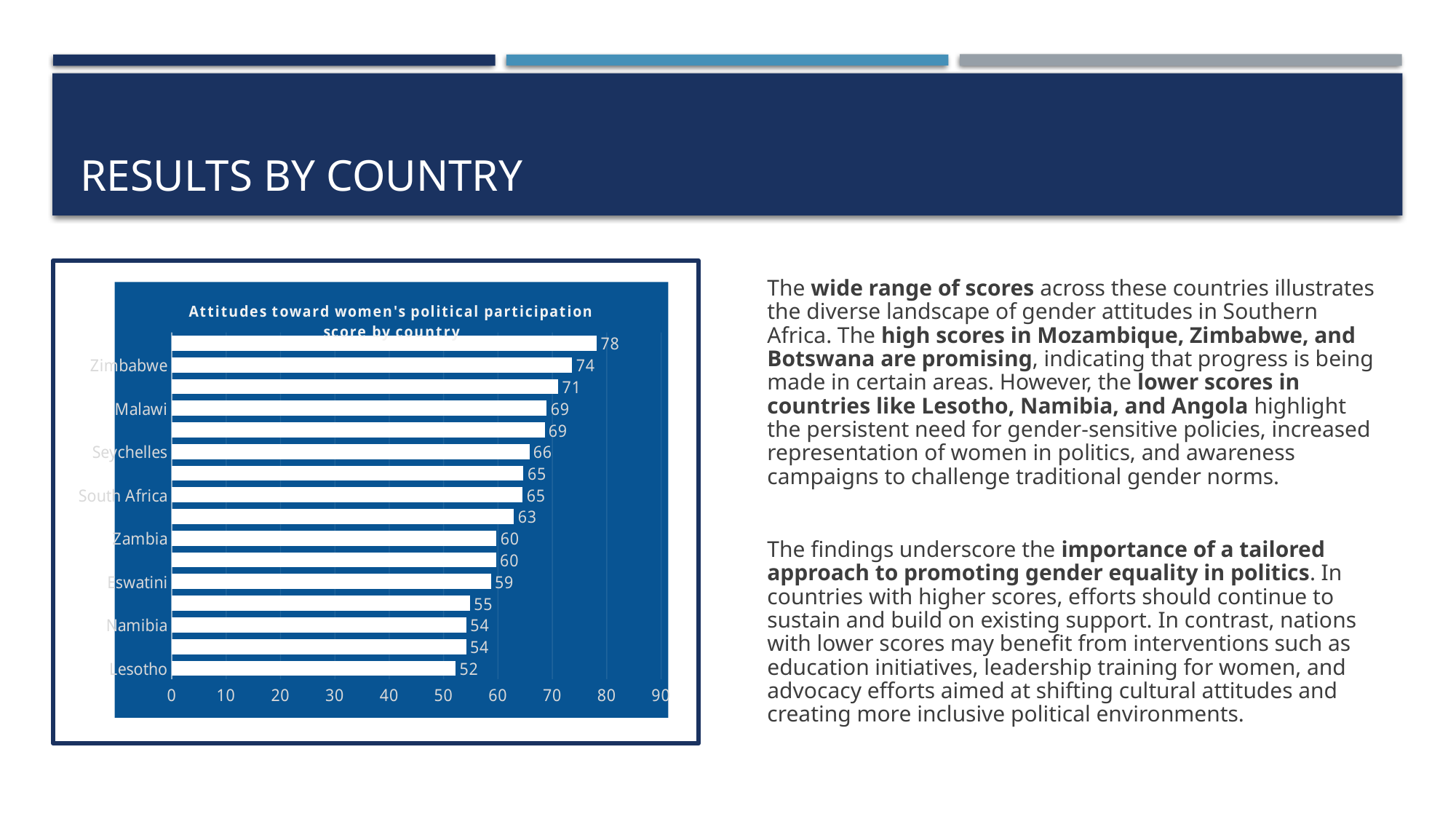
Which labelled country has the lowest score in the chart? Lesotho What is the highest score shown on any bar in the chart? 78 How many bars are plotted in the chart? 16 Which has a higher score, Malawi or Zambia? Malawi What score is shown for Namibia? 54 What score is shown for Eswatini? 59 What score is shown for Seychelles? 66 What score is shown for Zambia? 60 What score is shown for South Africa? 65 What score is shown for Malawi? 69 What is the difference between the scores for Zimbabwe and Lesotho? 22 What is the attitudes toward women's political participation score for Zimbabwe? 74